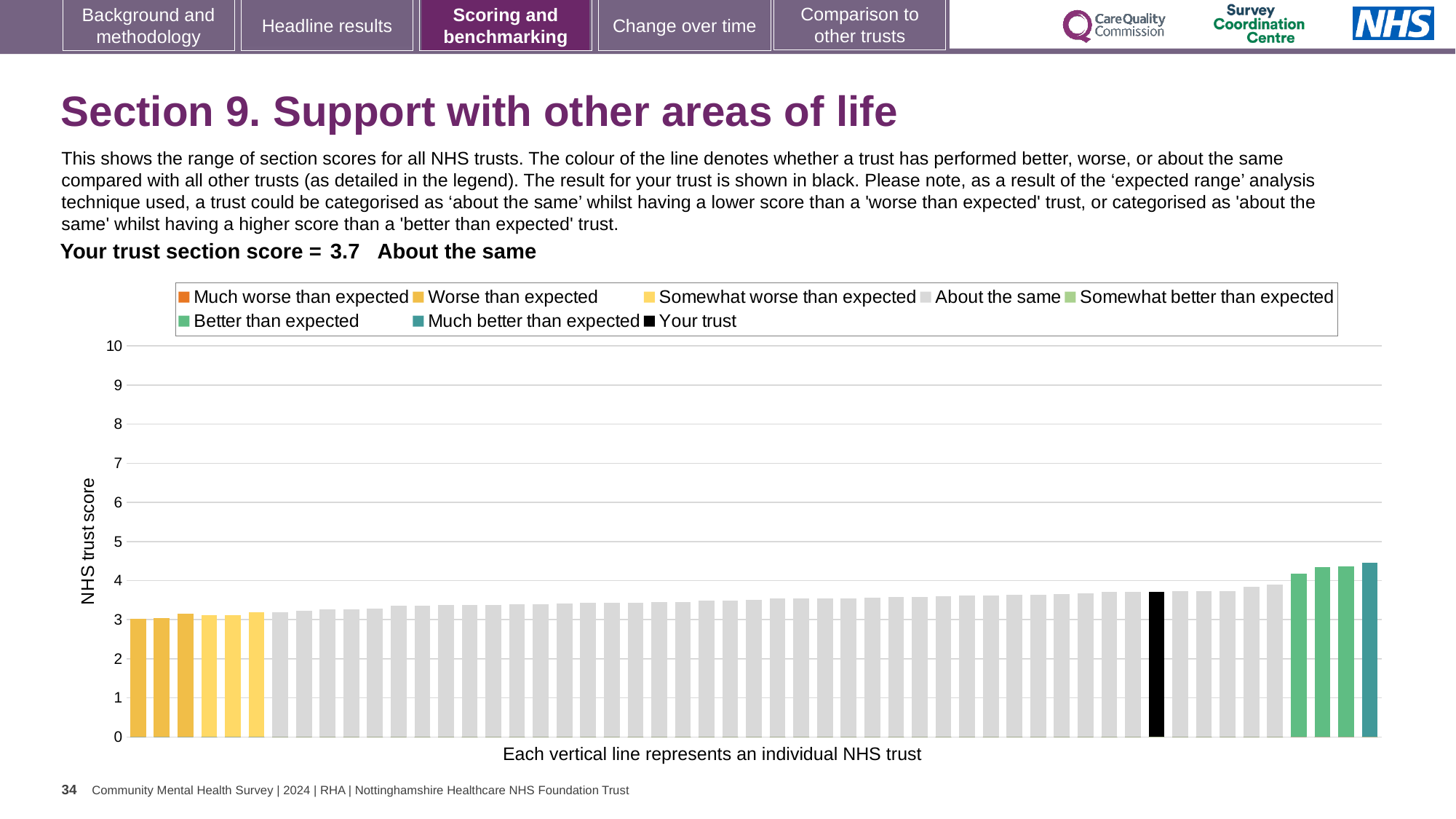
Which legend category do the shortest bars on the left belong to? Worse than expected Which legend category does the tallest bar belong to? Much better than expected How many entries does the chart legend list? 8 What kind of chart is shown on the slide? bar chart Is the value for your trust (the black bar) greater or less than 4? less What colour is the bar representing your trust? black Is the value for your trust (the black bar) greater or less than 3? greater What is the section score for your trust shown on the slide? 3.7 Is the value of the tallest bar in the chart greater or less than 4? greater What is the label on the y axis of the chart? NHS trust score Do the bar values rise or fall from left to right along the x axis? rise